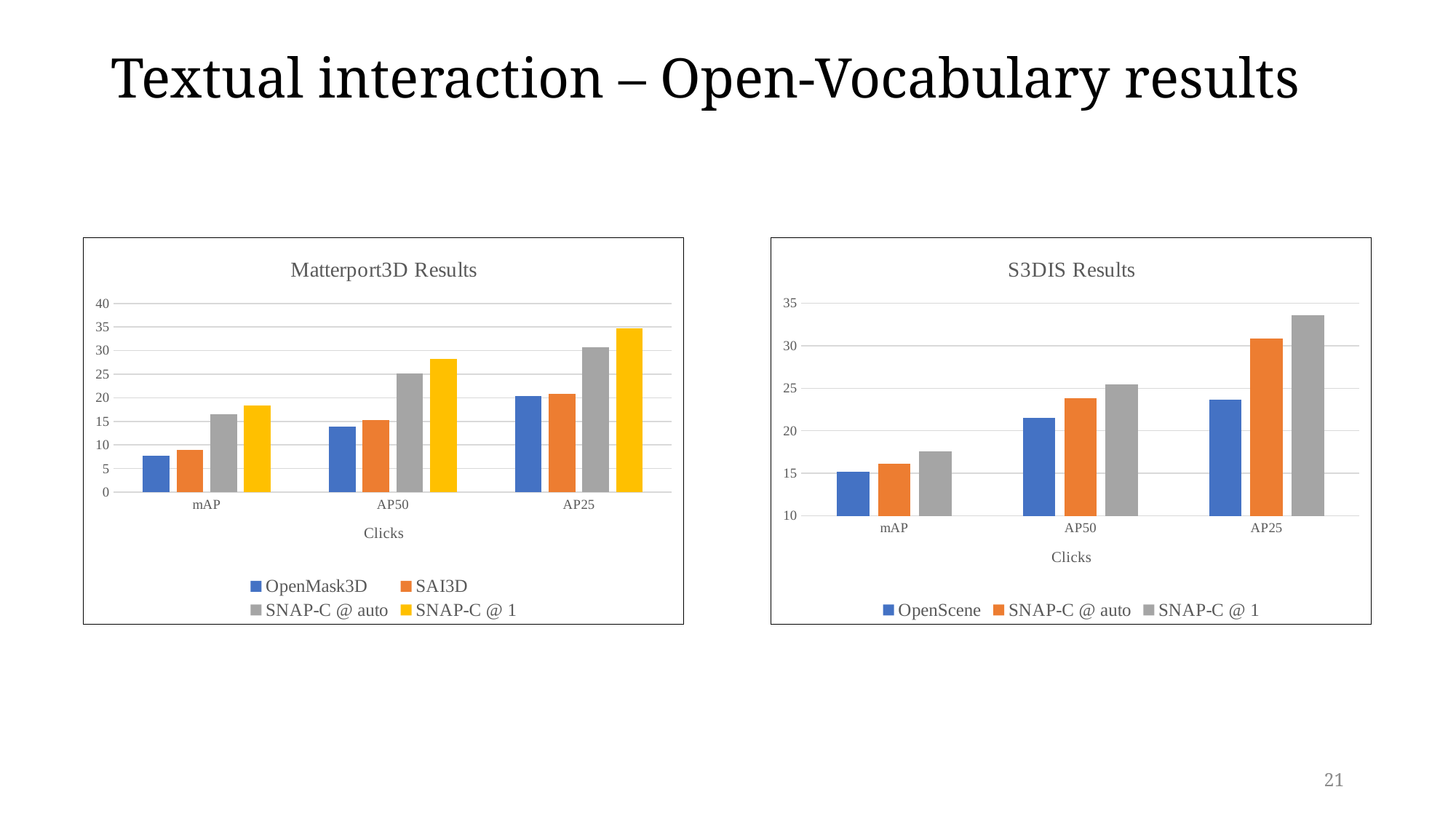
In the S3DIS Results chart, which series has the lowest value for mAP? OpenScene In the S3DIS Results chart, do the OpenScene values rise or fall from mAP to AP25? rise How many series does the legend of the Matterport3D Results chart list? 4 How many categories are shown on the x axis of the S3DIS Results chart? 3 In the Matterport3D Results chart, is the value for SNAP-C @ 1 at AP50 greater or less than 25? greater In the Matterport3D Results chart, which is larger at AP50: SAI3D or SNAP-C @ auto? SNAP-C @ auto In the S3DIS Results chart, is the value for SNAP-C @ auto at AP25 greater or less than 25? greater In the Matterport3D Results chart, is the value for OpenMask3D at mAP greater or less than 10? less What kind of chart is the Matterport3D Results chart? bar chart How many series does the legend of the S3DIS Results chart list? 3 In the Matterport3D Results chart, which series has the highest value for AP25? SNAP-C @ 1 What is the x-axis title of the S3DIS Results chart? Clicks